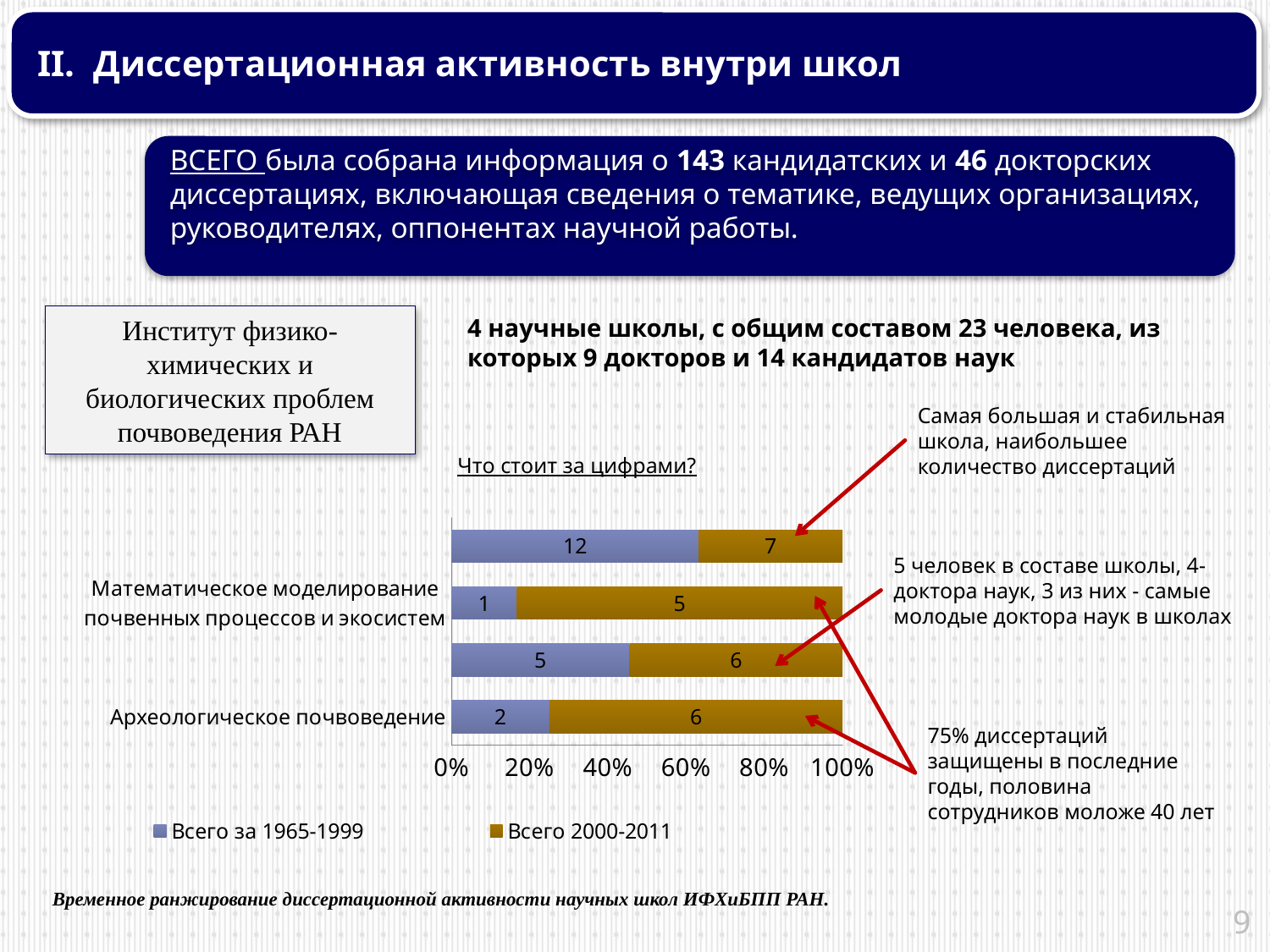
How many bars are plotted in the chart? 4 What is the total of the two series for "Математическое моделирование почвенных процессов и экосистем"? 6 How many series does the chart legend list? 2 For "Археологическое почвоведение", what is the difference between "Всего 2000-2011" and "Всего за 1965-1999"? 4 What is the value of "Всего 2000-2011" for "Археологическое почвоведение"? 6 What kind of chart is shown on the slide? bar chart What is the value of "Всего за 1965-1999" for "Археологическое почвоведение"? 2 What are the two legend entries of the chart? Всего за 1965-1999; Всего 2000-2011 For "Математическое моделирование почвенных процессов и экосистем", which series has the larger value: "Всего за 1965-1999" or "Всего 2000-2011"? Всего 2000-2011 What is the value of "Всего за 1965-1999" for "Математическое моделирование почвенных процессов и экосистем"? 1 What is the total of the two series for "Археологическое почвоведение"? 8 What is the value of "Всего 2000-2011" for "Математическое моделирование почвенных процессов и экосистем"? 5